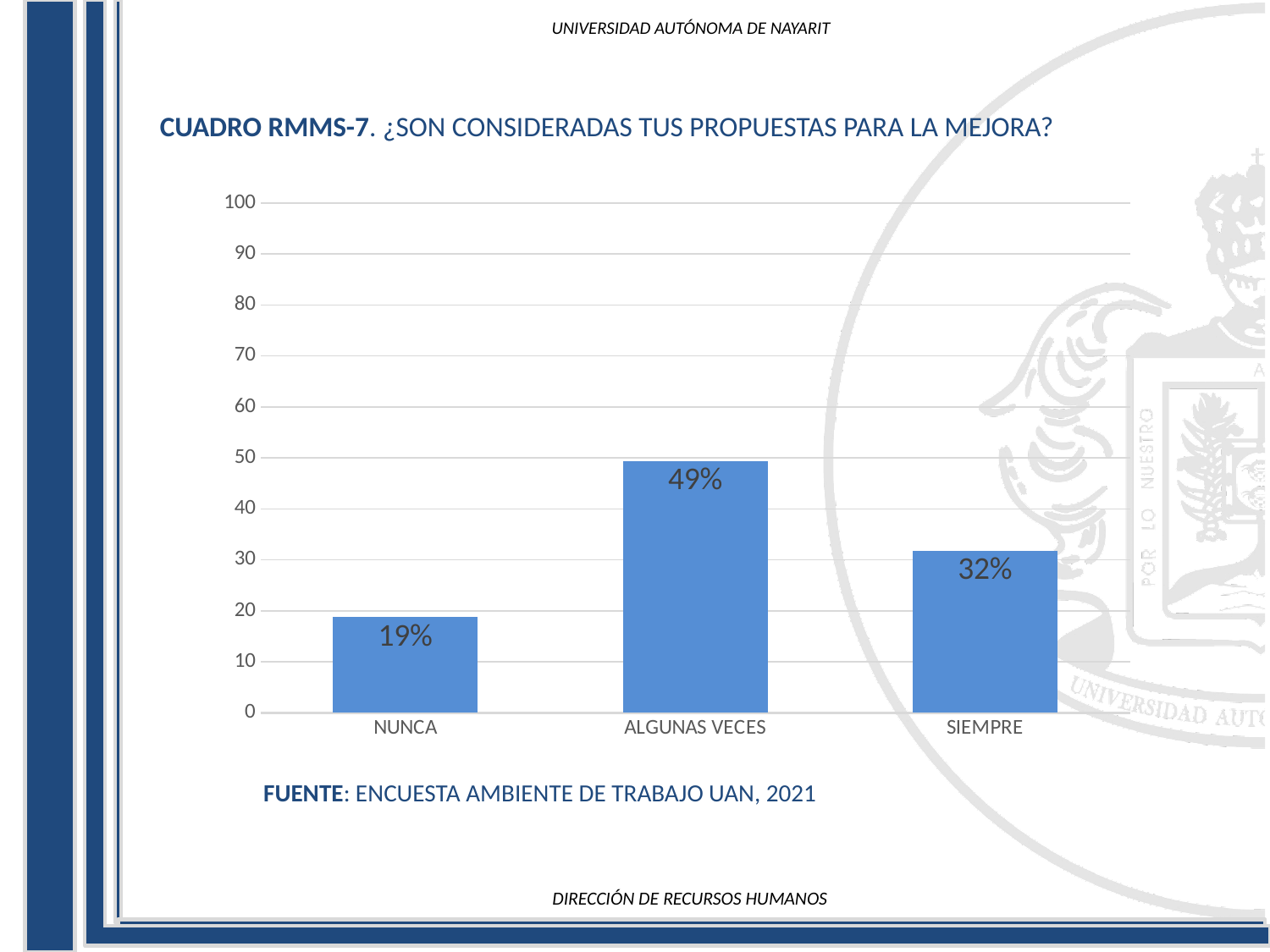
Is the value for ALGUNAS VECES greater or less than 40? greater What is the difference between the values for SIEMPRE and NUNCA? 13% What source is cited below the chart? ENCUESTA AMBIENTE DE TRABAJO UAN, 2021 How many categories are shown on the x axis? 3 What is the value for ALGUNAS VECES? 49% What kind of chart is shown on the slide? bar chart What is the difference between the values for ALGUNAS VECES and SIEMPRE? 17% What is the value for NUNCA? 19% Which is larger, the value for SIEMPRE or the value for NUNCA? SIEMPRE Which category has the highest value? ALGUNAS VECES What is the value for SIEMPRE? 32% Which category has the lowest value? NUNCA